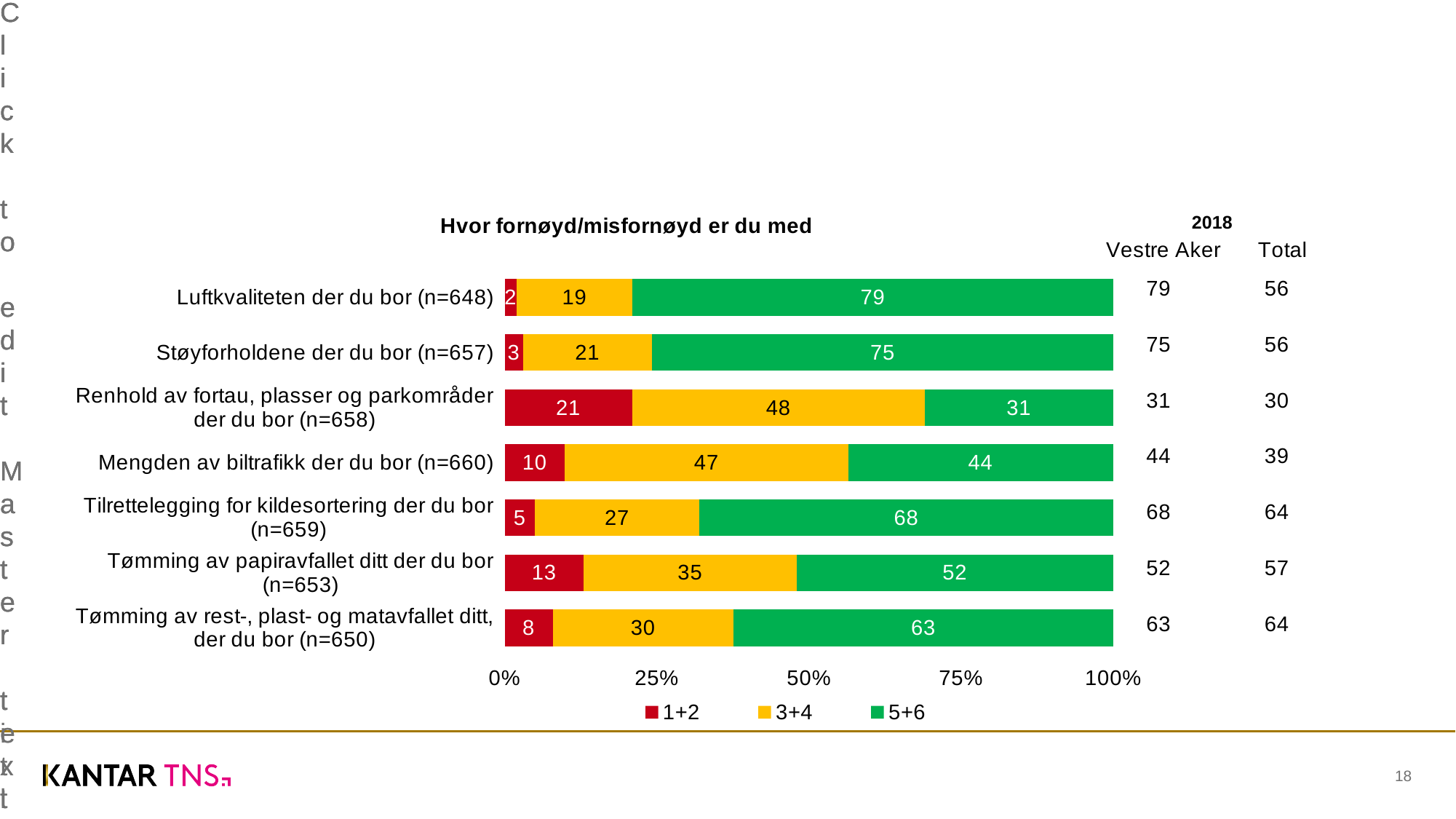
What is the 3+4 value for 'Renhold av fortau, plasser og parkområder der du bor (n=658)'? 48 Which category has the lowest 5+6 value? Renhold av fortau, plasser og parkområder der du bor (n=658) How many series does the legend list? 3 How many categories are shown on the chart? 7 Which colour represents the 5+6 series in the legend? Green What is the 1+2 value for 'Tømming av papiravfallet ditt der du bor (n=653)'? 13 What is the difference between the 5+6 values for 'Luftkvaliteten der du bor (n=648)' and 'Støyforholdene der du bor (n=657)'? 4 Which category has the highest 1+2 value? Renhold av fortau, plasser og parkområder der du bor (n=658) What is the 5+6 value for 'Luftkvaliteten der du bor (n=648)'? 79 What type of chart is shown on the slide? Stacked bar chart What is the title of the chart? Hvor fornøyd/misfornøyd er du med Which is larger: the 3+4 value for 'Mengden av biltrafikk der du bor (n=660)' or the 3+4 value for 'Tømming av rest-, plast- og matavfallet ditt, der du bor (n=650)'? Mengden av biltrafikk der du bor (n=660)